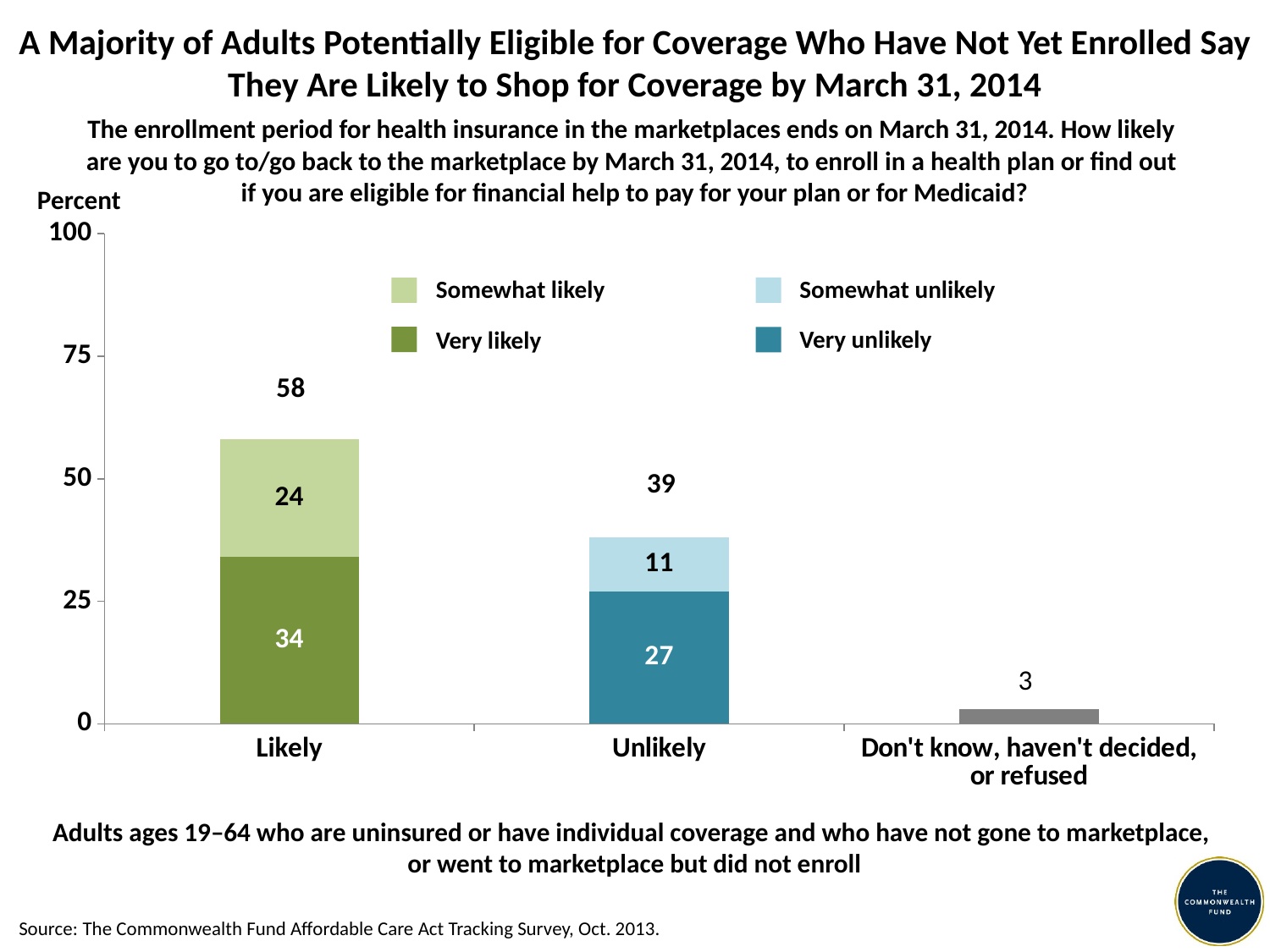
What is the value for the Don't know, haven't decided, or refused category? 3 How many categories are shown on the x axis? 3 What is the total of the Unlikely stacked bar? 39 How many series does the legend list? 4 Which is larger, Very likely or Very unlikely? Very likely What is the value for Somewhat unlikely in the Unlikely bar? 11 Which category has the highest total value? Likely What kind of chart is shown on the slide? Stacked bar chart What is the value for Very likely in the Likely bar? 34 What is the total of the Likely stacked bar? 58 Which category has the lowest value? Don't know, haven't decided, or refused What is the difference between the Likely total and the Unlikely total? 19